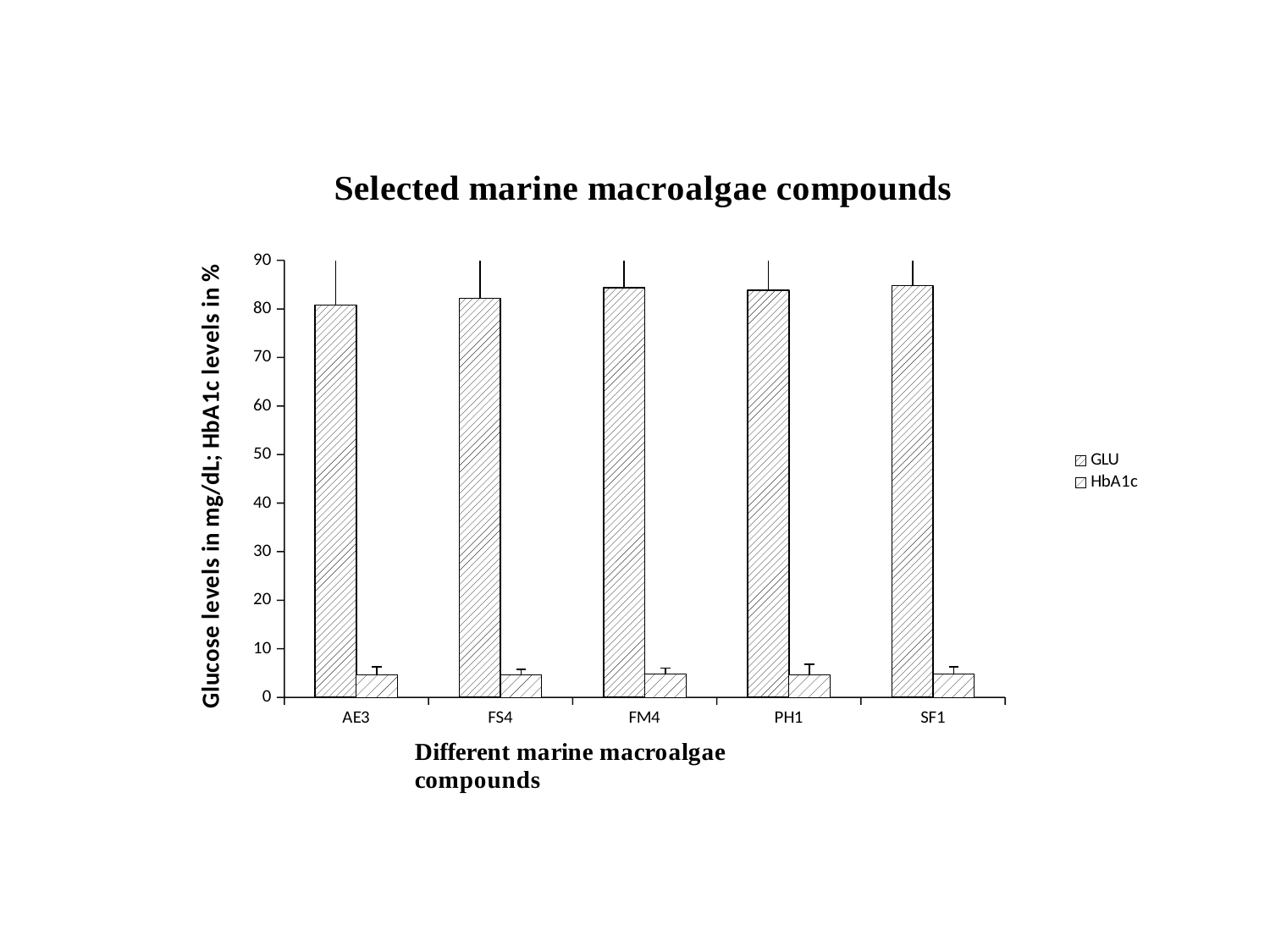
Is the HbA1c value for SF1 greater or less than 20? less Is the GLU value for AE3 greater or less than 70? greater How many series does the legend list? 2 Is the GLU value for PH1 greater or less than 60? greater What is the title of the chart? Selected marine macroalgae compounds For FS4, which is larger, the GLU value or the HbA1c value? GLU How many marine macroalgae compounds are shown on the x axis? 5 What kind of chart is shown on the slide? bar chart Which two series are listed in the legend? GLU and HbA1c For PH1, which series has the smaller value, GLU or HbA1c? HbA1c